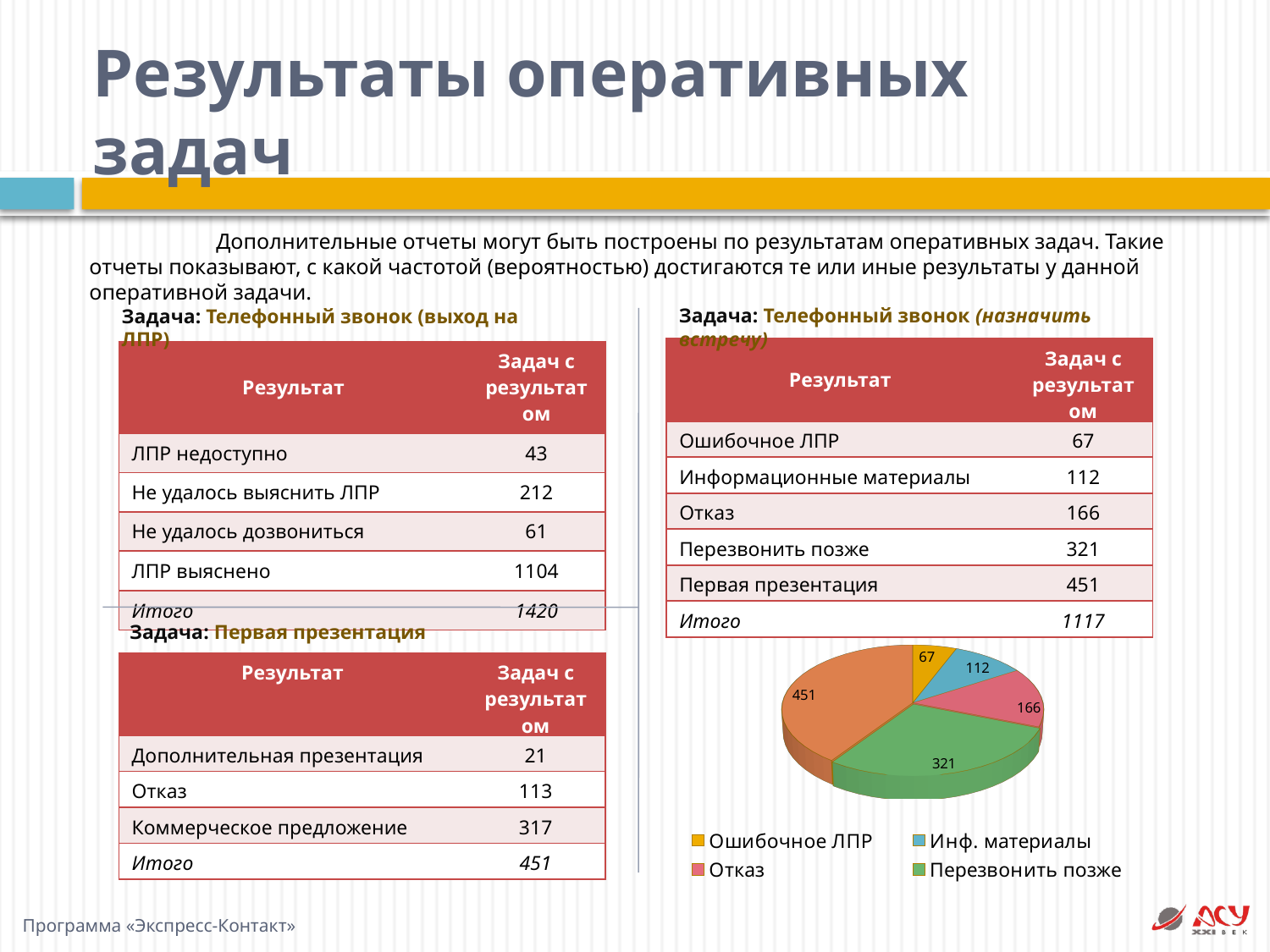
In the pie chart, what is the value for Перезвонить позже? 321 What kind of chart is shown on the slide? Pie chart In the pie chart, how much larger is Перезвонить позже than Отказ? 155 What is the total of all slice values in the pie chart? 1117 What is the value of the largest slice in the pie chart? 451 In the pie chart, what is the value for Отказ? 166 What colour is the Перезвонить позже slice in the pie chart? Green How many entries does the pie chart's legend list? 4 In the pie chart, what is the value for Ошибочное ЛПР? 67 In the pie chart, which is larger: Инф. материалы or Отказ? Отказ Which legend category has the smallest slice in the pie chart? Ошибочное ЛПР How many slices does the pie chart have? 5